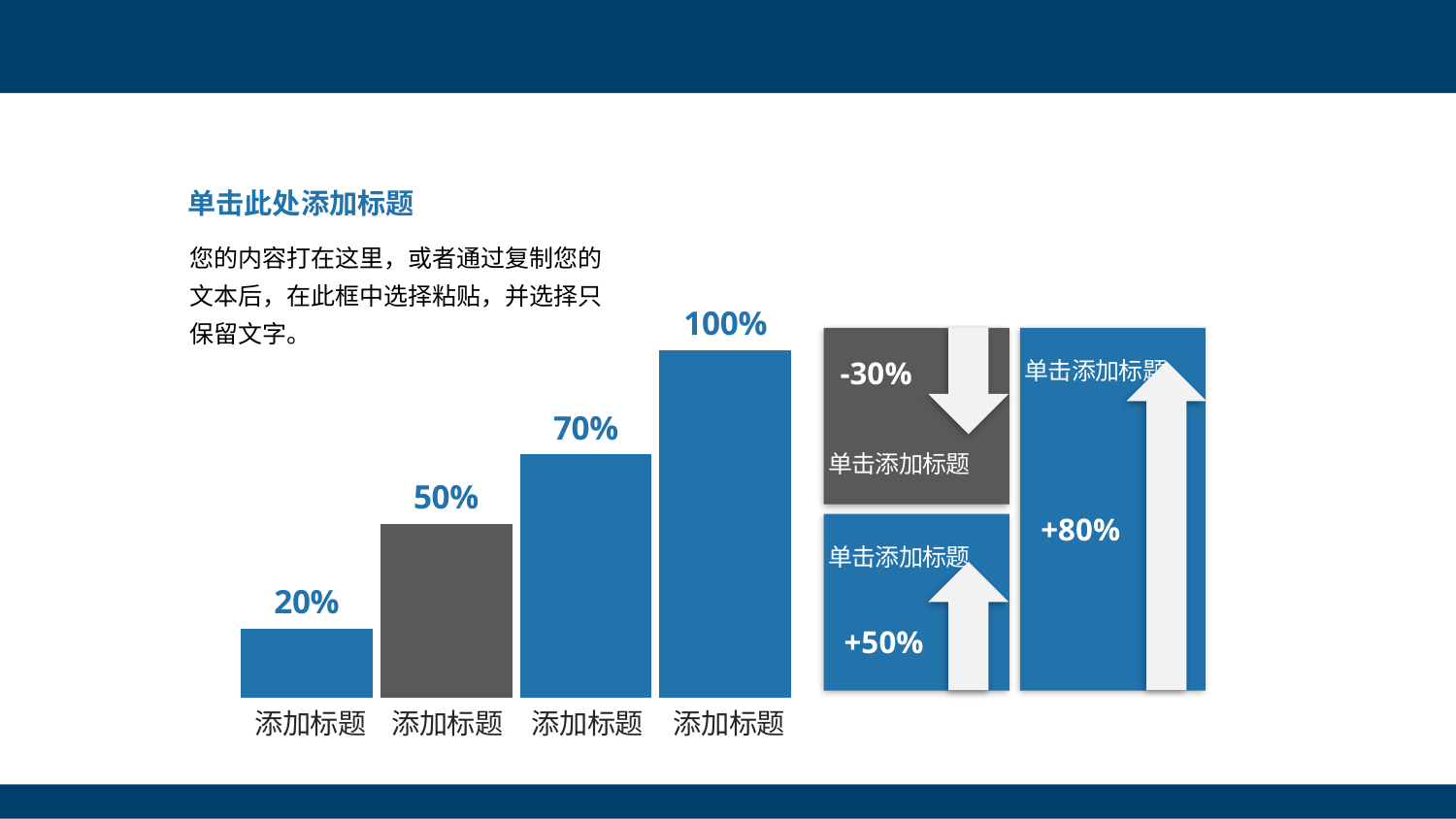
Which bar in the bar chart has the lowest value? the first (leftmost) bar, 20% Do the bar values rise or fall from left to right in the bar chart? rise How many bars does the bar chart have? 4 What is the difference between the fourth bar and the first bar in the bar chart? 80% What type of chart is shown on the slide? bar chart Which bar in the bar chart has the highest value? the fourth (rightmost) bar, 100% What is the value of the third bar in the bar chart? 70% What is the value of the second bar in the bar chart? 50% What is the value of the fourth (rightmost) bar in the bar chart? 100% What is the difference between the third bar and the second bar in the bar chart? 20% Which bar in the bar chart is coloured dark grey instead of blue? the second bar (50%) What is the value of the first (leftmost) bar in the bar chart? 20%